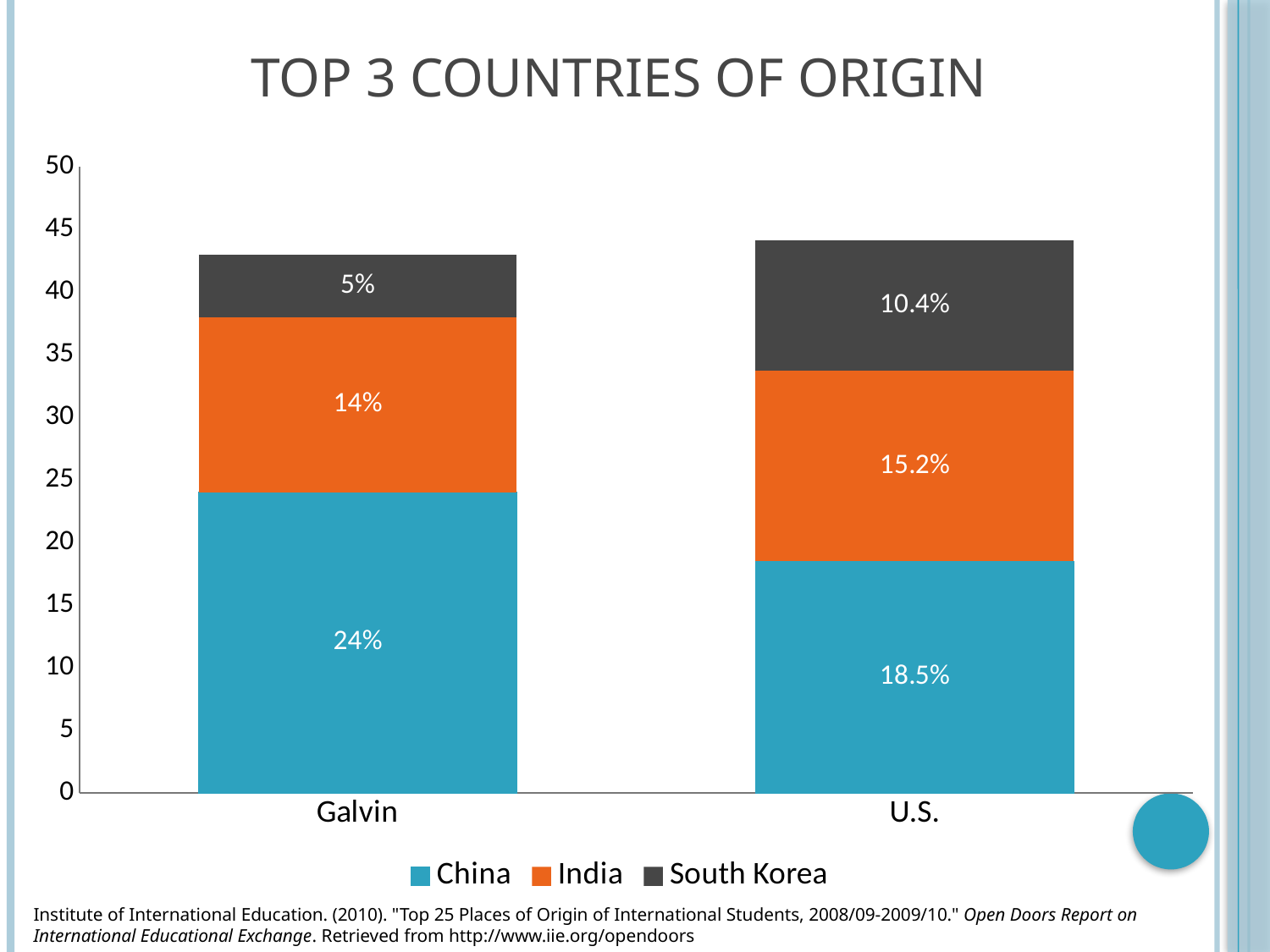
How many series does the legend list? 3 What is the value for China in the Galvin bar? 24% Which country has the largest share in the Galvin bar? China What is the difference between the China values for Galvin and U.S.? 5.5% What is the value for South Korea in the Galvin bar? 5% What kind of chart is shown on the slide? Stacked bar chart How many categories are shown on the x axis? 2 Which country has the smallest share in the U.S. bar? South Korea What is the value for India in the U.S. bar? 15.2% Which is larger, the South Korea value for Galvin or for U.S.? U.S. What is the total of the Galvin stacked bar? 43% What is the value for South Korea in the U.S. bar? 10.4%